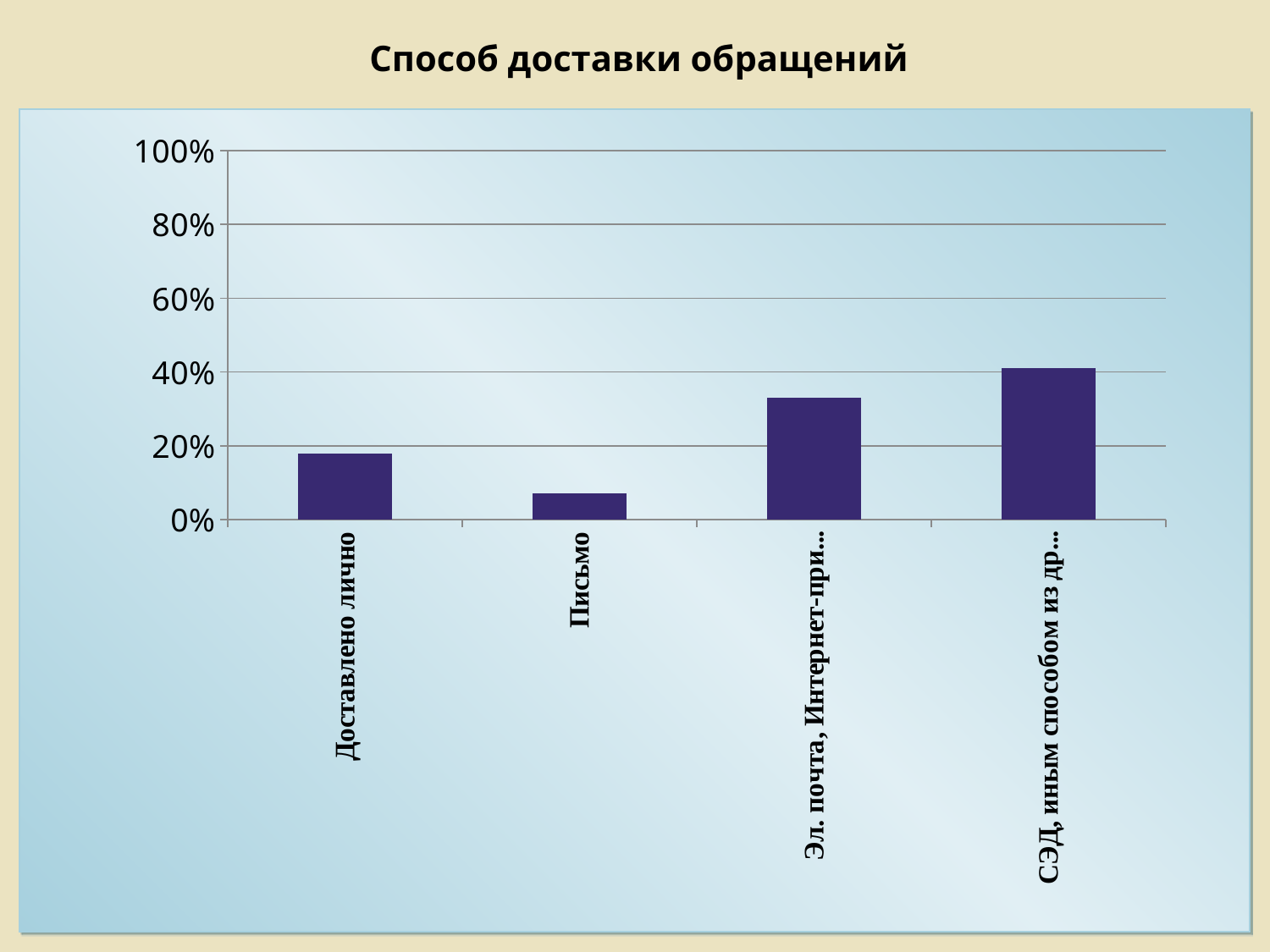
What is the title of the chart? Способ доставки обращений What kind of chart is shown on the slide? bar chart What is the highest value shown on the vertical axis of the chart? 100% Which is larger, the value for Письмо or the value for Эл. почта, Интернет-при...? Эл. почта, Интернет-при... Is the value for Письмо greater or less than 20%? less Which category has the highest bar? СЭД, иным способом из др... Is the value for СЭД, иным способом из др... greater or less than 60%? less Is the value for Эл. почта, Интернет-при... greater or less than 20%? greater Which category has the lowest bar? Письмо How many categories are shown on the x axis of the chart? 4 Which is larger, the value for Доставлено лично or the value for Письмо? Доставлено лично